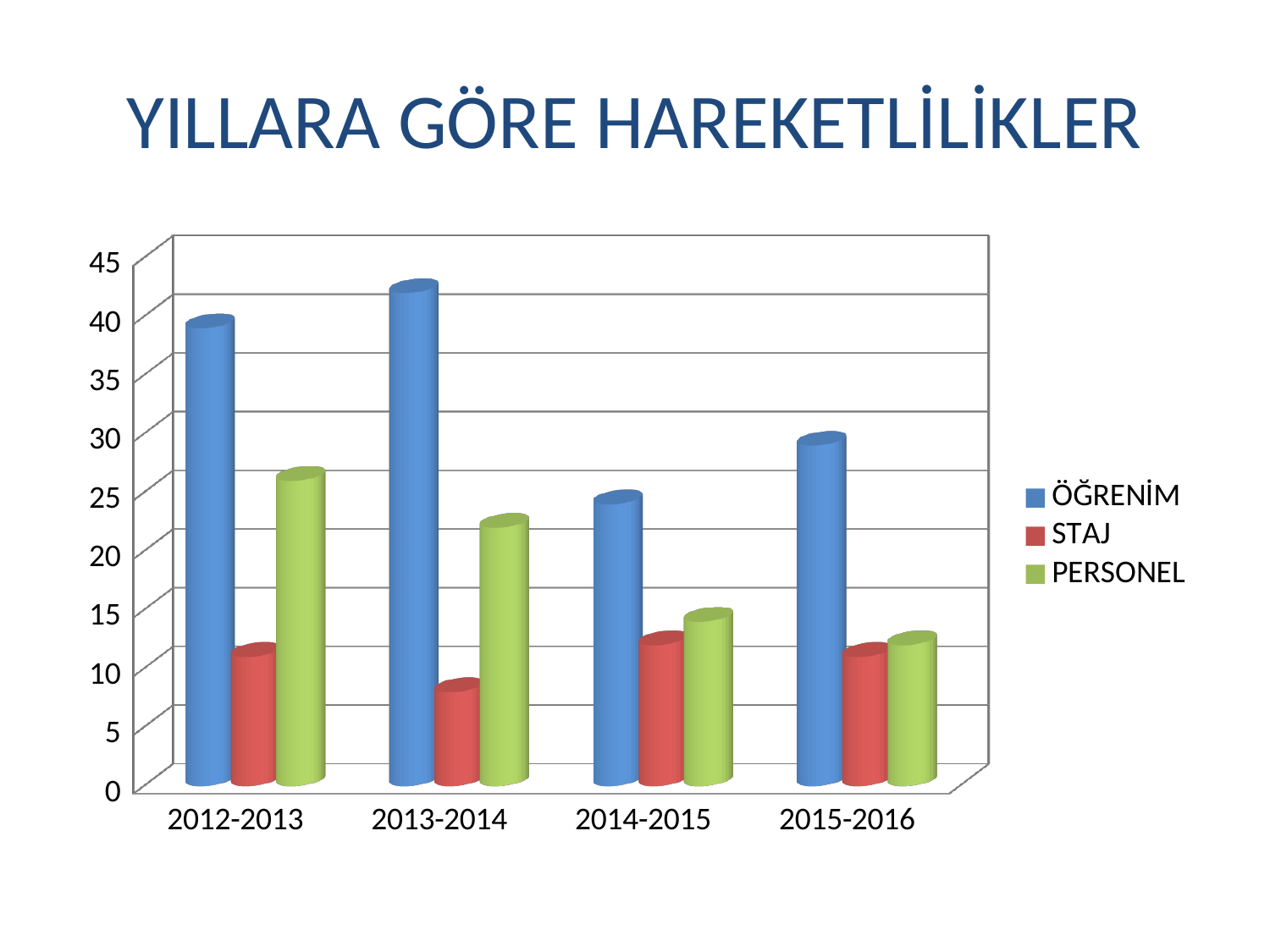
How many series does the legend list? 3 Is the PERSONEL value for 2014-2015 greater or less than 20? less Is the ÖĞRENİM value for 2015-2016 greater or less than 25? greater Is the ÖĞRENİM value for 2013-2014 greater or less than 40? greater In which year is the PERSONEL value highest? 2012-2013 In 2012-2013, which is larger: ÖĞRENİM or PERSONEL? ÖĞRENİM In which year is the STAJ value lowest? 2013-2014 How many academic-year categories are shown on the x axis? 4 In which year is the ÖĞRENİM value highest? 2013-2014 Do the PERSONEL values rise or fall from 2012-2013 to 2015-2016? fall What kind of chart is shown on the slide? bar chart